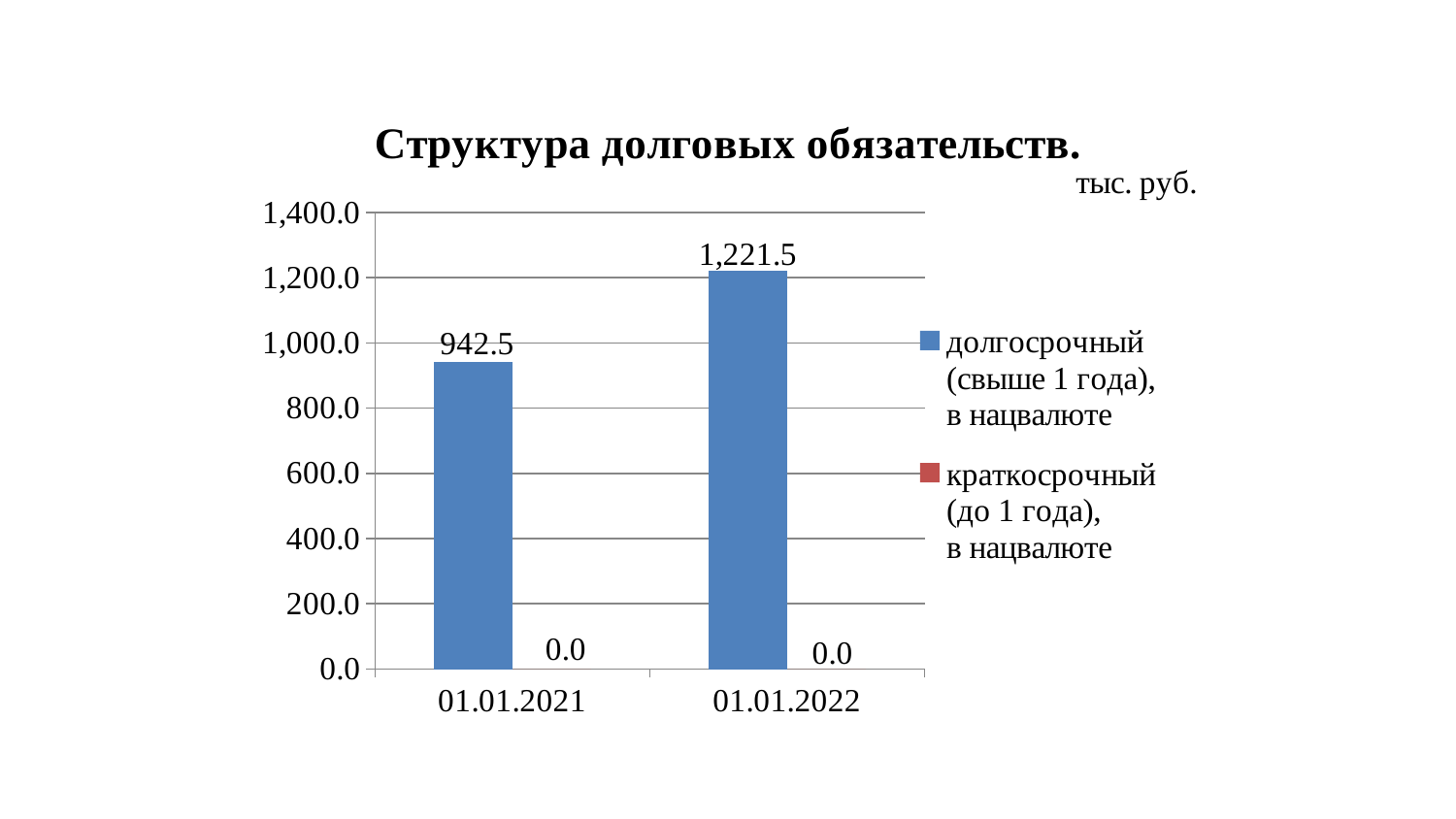
What is the value of долгосрочный (свыше 1 года), в нацвалюте on 01.01.2021? 942.5 On which date is the долгосрочный (свыше 1 года) value lowest? 01.01.2021 What kind of chart is shown? bar chart What is the value of долгосрочный (свыше 1 года), в нацвалюте on 01.01.2022? 1,221.5 How many series does the legend list? 2 What is the value of краткосрочный (до 1 года), в нацвалюте on 01.01.2021? 0.0 Is the долгосрочный value on 01.01.2021 greater or less than 1,000.0? less How many dates are shown on the x axis? 2 Which is larger: the долгосрочный value on 01.01.2021 or on 01.01.2022? 01.01.2022 What is the value of краткосрочный (до 1 года), в нацвалюте on 01.01.2022? 0.0 On which date is the долгосрочный (свыше 1 года) value highest? 01.01.2022 What is the difference between the долгосрочный values on 01.01.2022 and 01.01.2021? 279.0